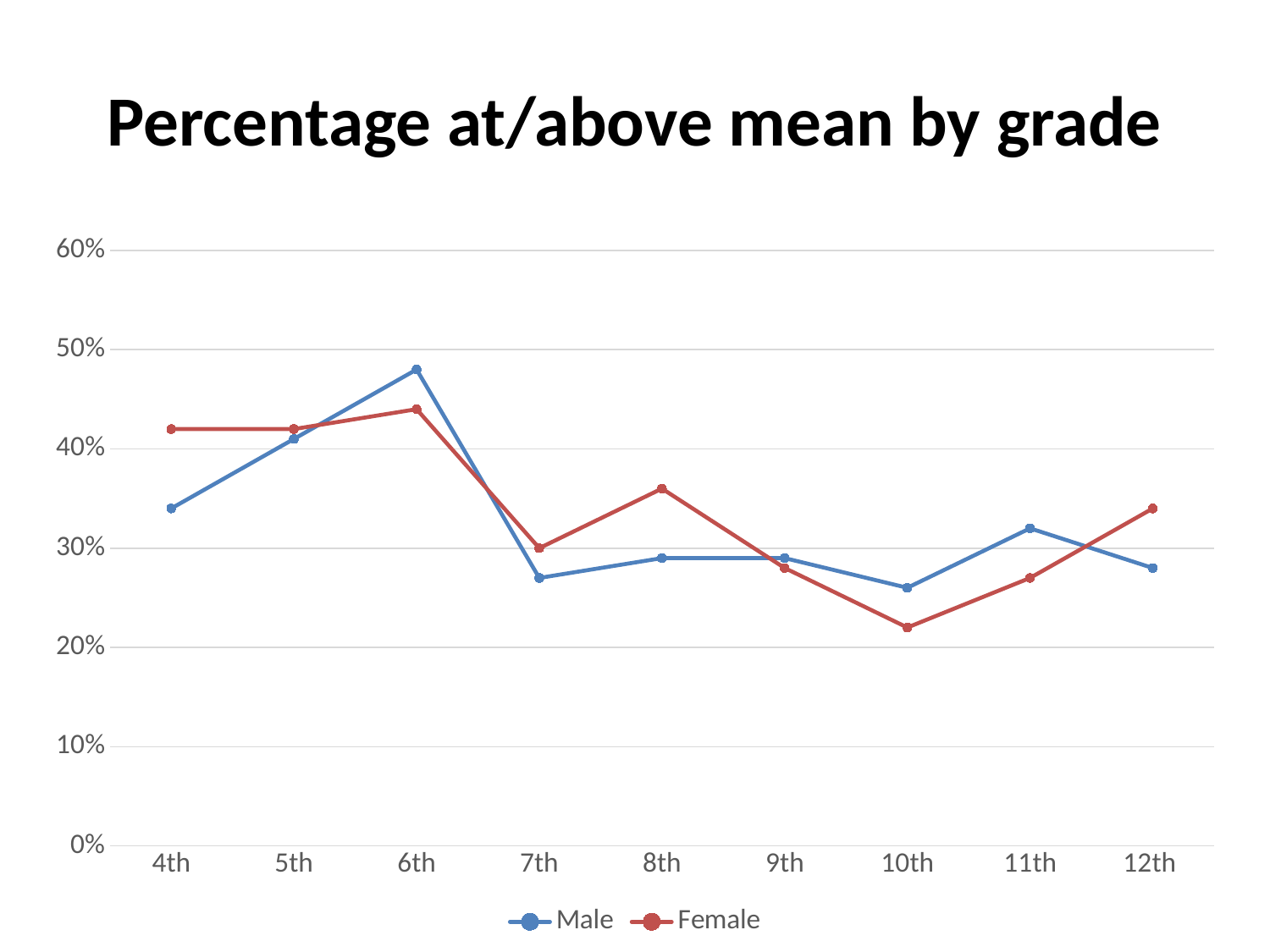
At 4th grade, which series has the higher value, Male or Female? Female How many grade levels are plotted along the x axis? 9 What is the title of the chart? Percentage at/above mean by grade How many series does the legend list? 2 Is the Male value for 6th grade greater or less than 40%? greater Which grade has the highest value for the Male series? 6th Is the Female value for 8th grade greater or less than 30%? greater What kind of chart is shown on the slide? Line chart Is the Female value for 10th grade greater or less than 30%? less Does the Male series rise or fall from 6th grade to 7th grade? Fall At 6th grade, which series has the higher value, Male or Female? Male Which grade has the lowest value for the Female series? 10th